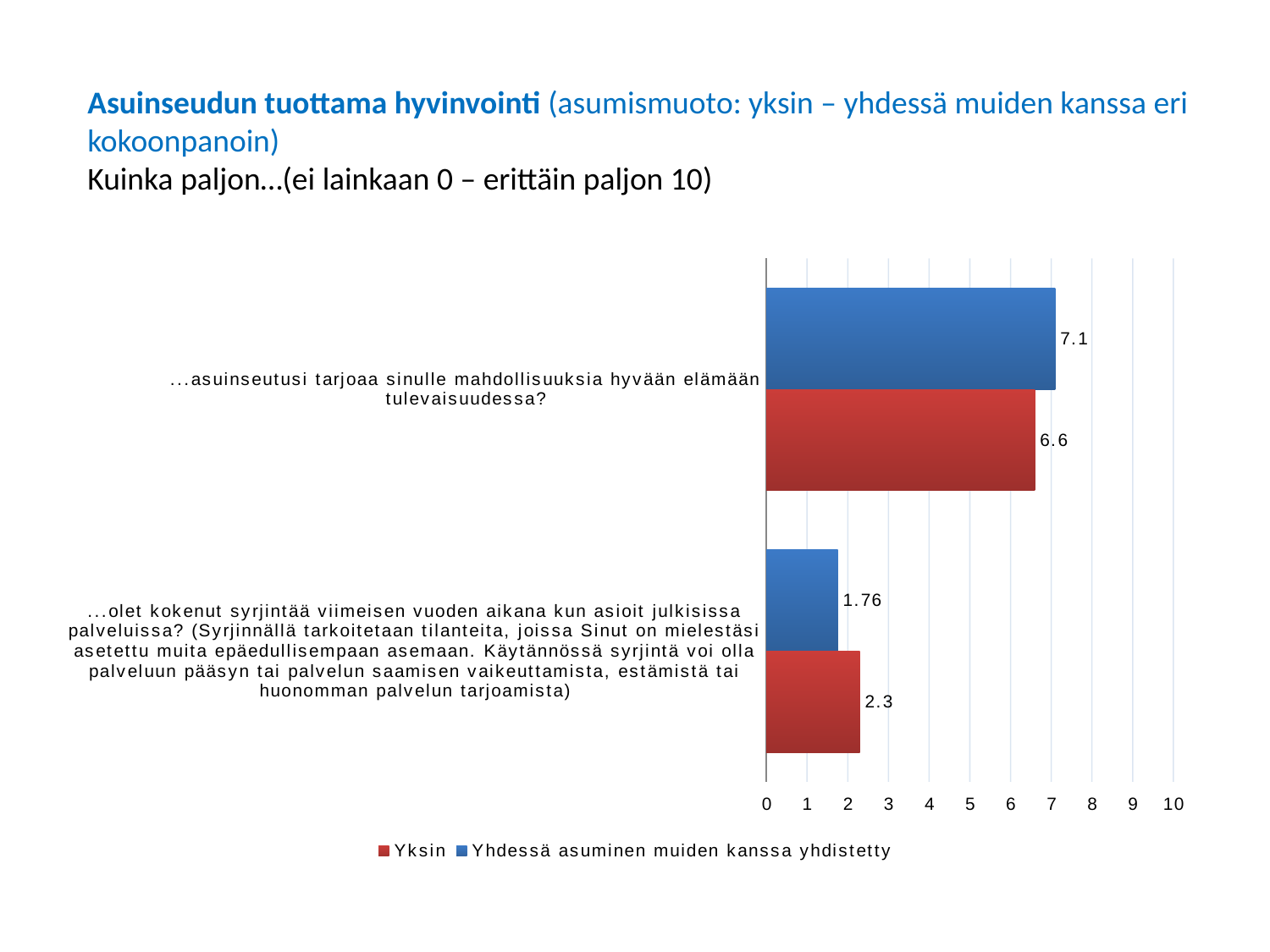
What is the difference between the "Yhdessä asuminen muiden kanssa yhdistetty" and "Yksin" values for "...asuinseutusi tarjoaa sinulle mahdollisuuksia hyvään elämään tulevaisuudessa?"? 0.5 What kind of chart is shown on the slide? Bar chart What is the value for "Yhdessä asuminen muiden kanssa yhdistetty" on the question "...asuinseutusi tarjoaa sinulle mahdollisuuksia hyvään elämään tulevaisuudessa?"? 7.1 What is the difference between the "Yksin" and "Yhdessä asuminen muiden kanssa yhdistetty" values for the question about experiencing discrimination in public services? 0.54 Which bar in the chart has the highest value? Yhdessä asuminen muiden kanssa yhdistetty, 7.1 What is the value for "Yhdessä asuminen muiden kanssa yhdistetty" on the question about experiencing discrimination in public services? 1.76 What is the value for "Yksin" on the question about experiencing discrimination in public services ("...olet kokenut syrjintää viimeisen vuoden aikana...")? 2.3 What is the value for "Yksin" on the question "...asuinseutusi tarjoaa sinulle mahdollisuuksia hyvään elämään tulevaisuudessa?"? 6.6 How many series does the legend list? 2 Which series has the higher value for "...asuinseutusi tarjoaa sinulle mahdollisuuksia hyvään elämään tulevaisuudessa?"? Yhdessä asuminen muiden kanssa yhdistetty Which series has the higher value for the question about experiencing discrimination in public services? Yksin Which bar in the chart has the lowest value? Yhdessä asuminen muiden kanssa yhdistetty, 1.76